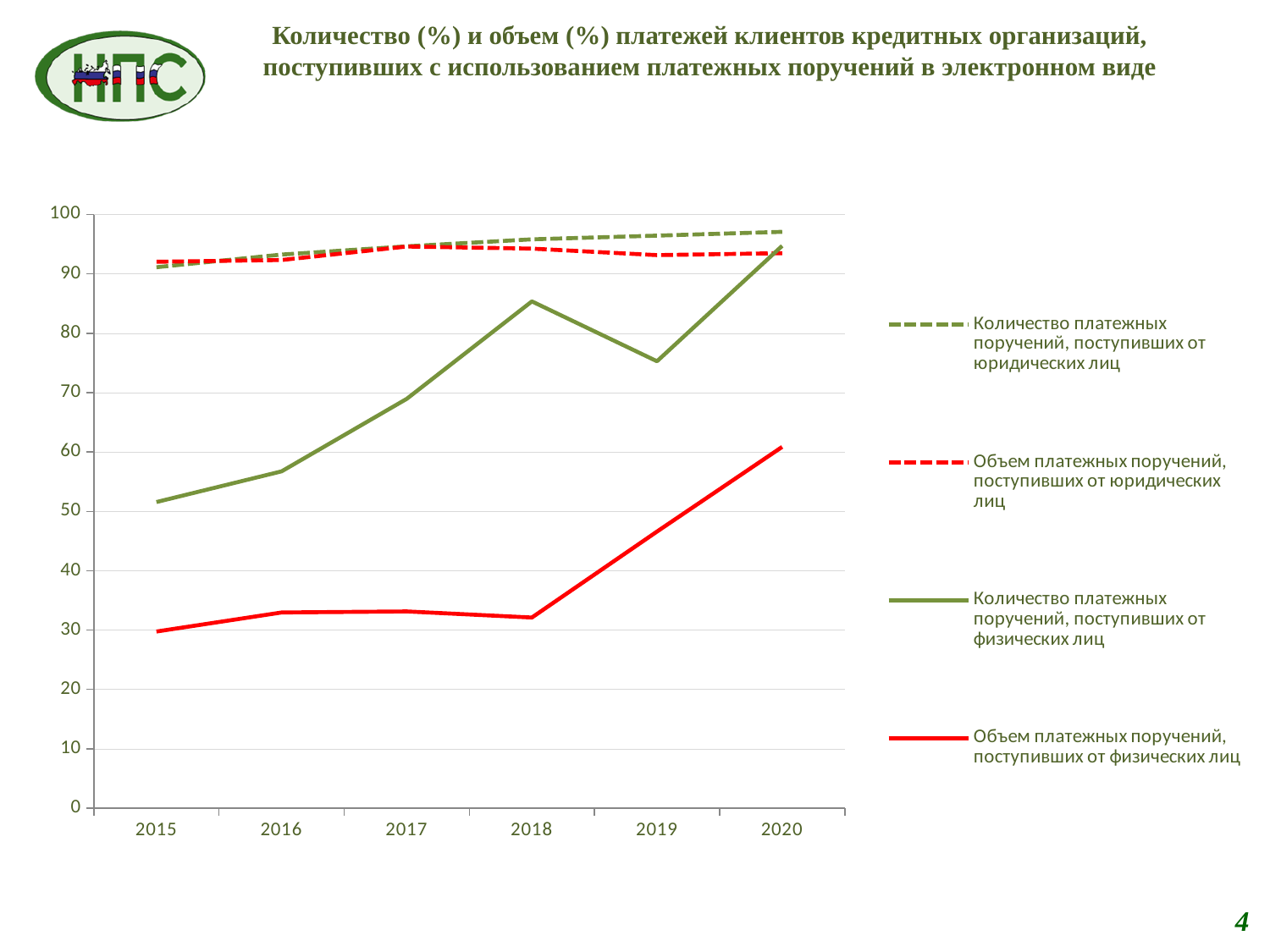
How many series does the legend list? 4 In which year is 'Объем платежных поручений, поступивших от физических лиц' highest? 2020 Is the value for 'Количество платежных поручений, поступивших от физических лиц' in 2019 greater or less than 80? less Is the value for 'Объем платежных поручений, поступивших от юридических лиц' in 2020 greater or less than 90? greater How many years are shown on the x axis? 6 Is the value for 'Объем платежных поручений, поступивших от физических лиц' in 2020 greater or less than 50? greater Which series is drawn as a dashed green line? Количество платежных поручений, поступивших от юридических лиц Does the line for 'Объем платежных поручений, поступивших от физических лиц' rise or fall from 2018 to 2020? rises In 2019, which is larger: 'Количество платежных поручений, поступивших от физических лиц' or 'Объем платежных поручений, поступивших от физических лиц'? Количество платежных поручений, поступивших от физических лиц What kind of chart is shown on the slide? line chart In which year is 'Количество платежных поручений, поступивших от физических лиц' lowest? 2015